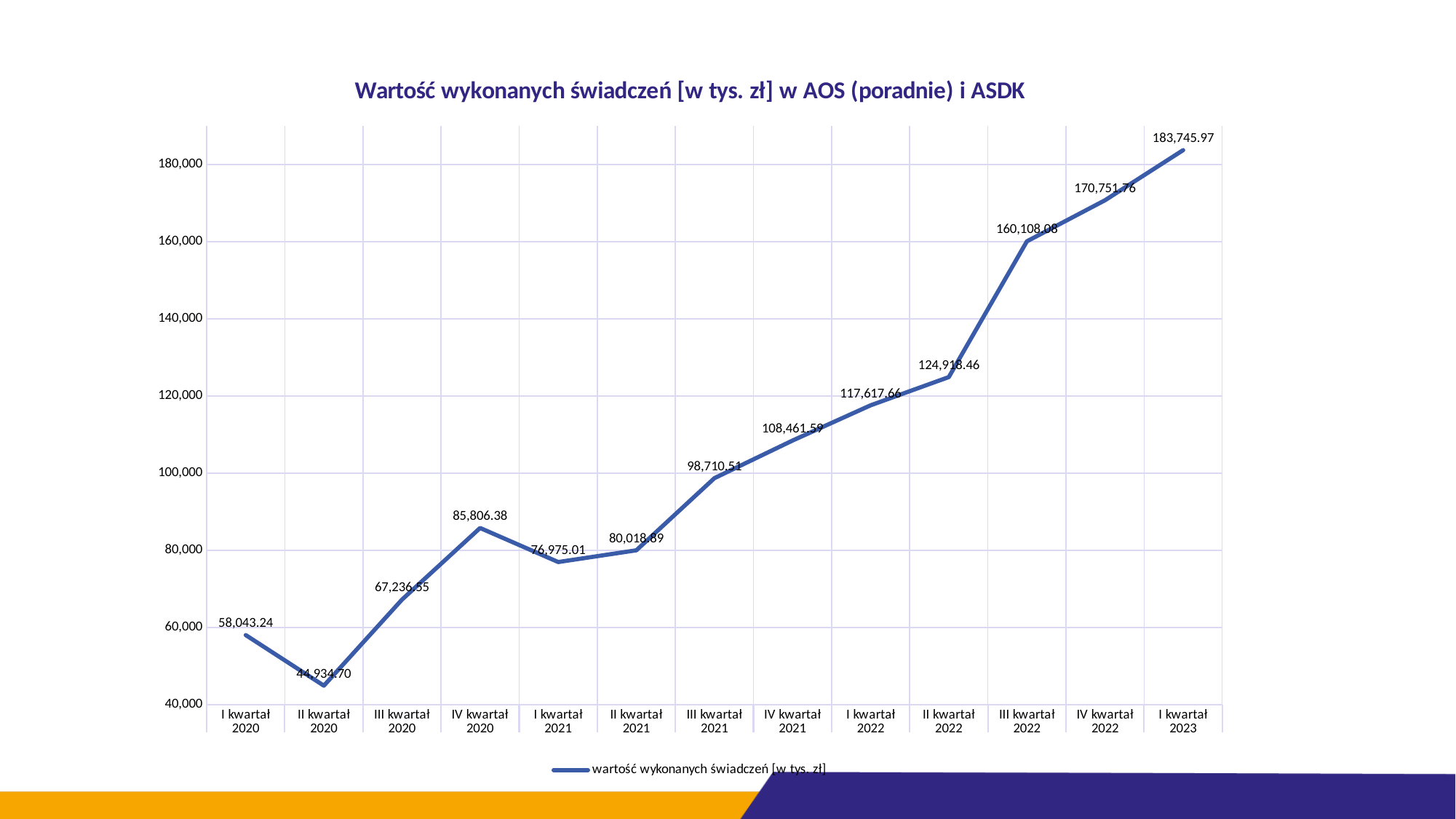
How many quarters are plotted on the chart? 13 What is the value for II kwartał 2020? 44,934.70 What is the value for IV kwartał 2020? 85,806.38 What is the difference between the values for I kwartał 2023 and IV kwartał 2022? 12,994.21 What is the value for I kwartał 2023? 183,745.97 Which quarter has the highest value? I kwartał 2023 Which is larger, the value for IV kwartał 2020 or the value for I kwartał 2021? IV kwartał 2020 Is the value for III kwartał 2022 greater or less than 140,000? greater What is the value for III kwartał 2021? 98,710.51 What kind of chart is shown? line chart Which quarter has the lowest value? II kwartał 2020 Do the values generally rise or fall from I kwartał 2020 to I kwartał 2023? rise